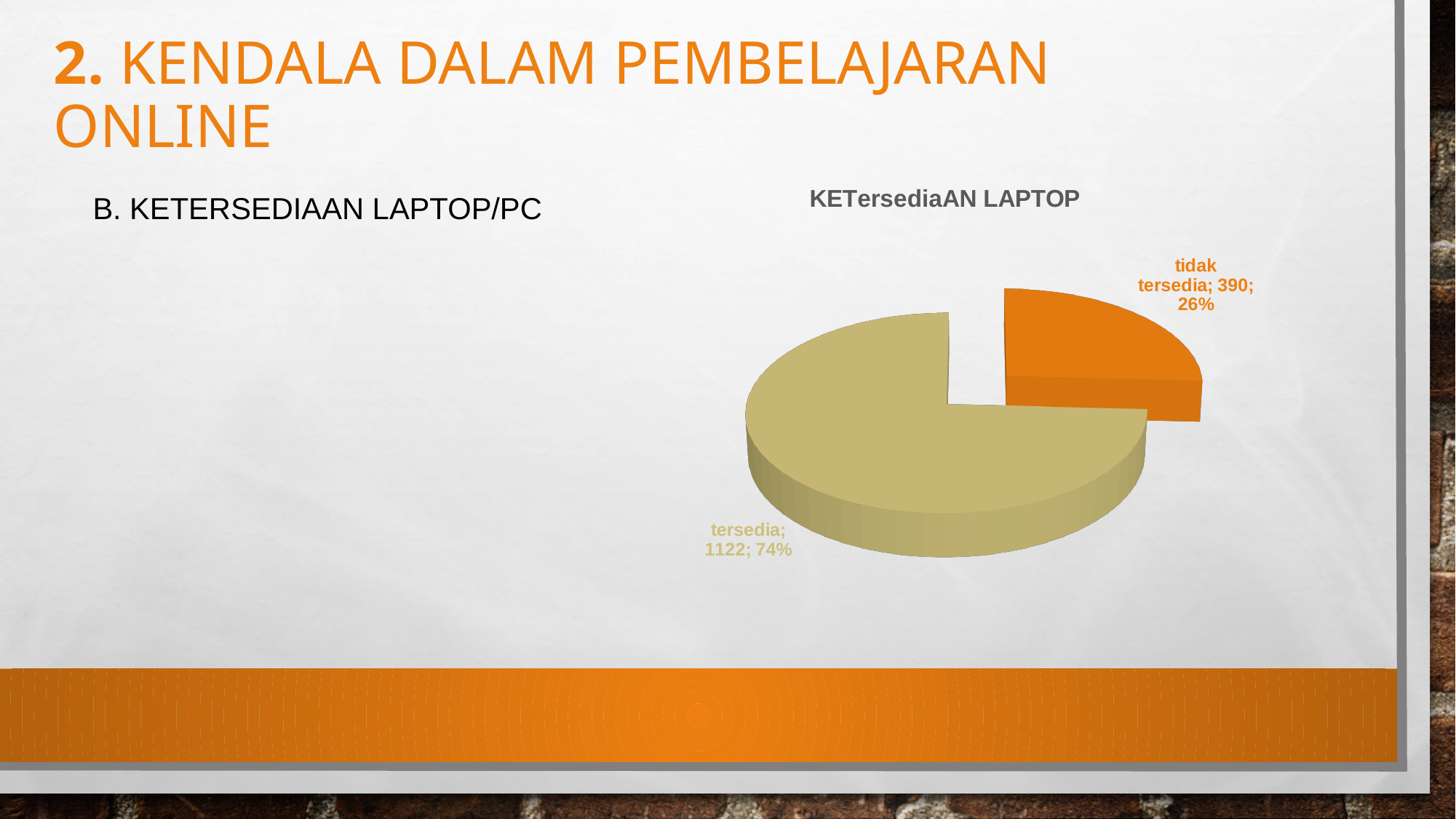
Which is larger, 'tersedia' or 'tidak tersedia'? tersedia What is the value for 'tidak tersedia'? 390 What is the title of the chart? KETersediaAN LAPTOP What kind of chart is shown on the slide? Pie chart What is the value for 'tersedia'? 1122 What share of the pie does 'tidak tersedia' represent? 26% What is the total of the two slices in the pie chart? 1512 What share of the pie does 'tersedia' represent? 74% Which slice is the smallest? tidak tersedia What is the difference between the values for 'tersedia' and 'tidak tersedia'? 732 How many slices does the pie chart have? 2 Which slice is the largest? tersedia